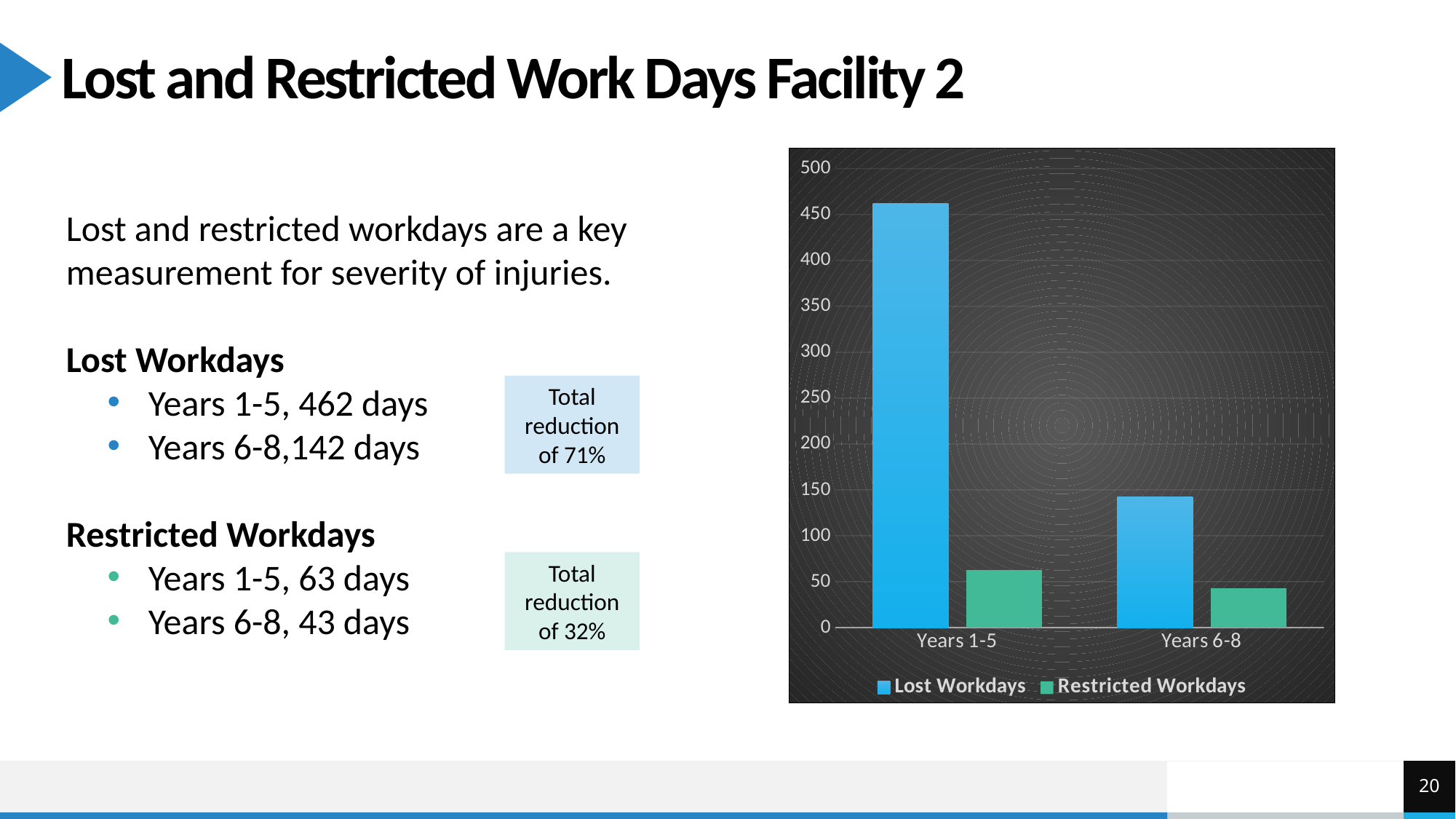
What kind of chart is shown on the slide? bar chart What are the two series named in the chart legend? Lost Workdays and Restricted Workdays How many series does the chart legend list? 2 How many categories are shown on the x axis of the chart? 2 What is the value of Restricted Workdays for Years 6-8? 43 days Which bar in the chart is the lowest overall? Restricted Workdays, Years 6-8 Is the Lost Workdays value for Years 6-8 greater or less than 200? less Do the Lost Workdays values rise or fall from Years 1-5 to Years 6-8? fall What is the value of Lost Workdays for Years 1-5? 462 days Which is larger: Restricted Workdays for Years 1-5 or Lost Workdays for Years 6-8? Lost Workdays for Years 6-8 Is the Lost Workdays value for Years 1-5 greater or less than 400? greater Which category has the highest Lost Workdays bar? Years 1-5